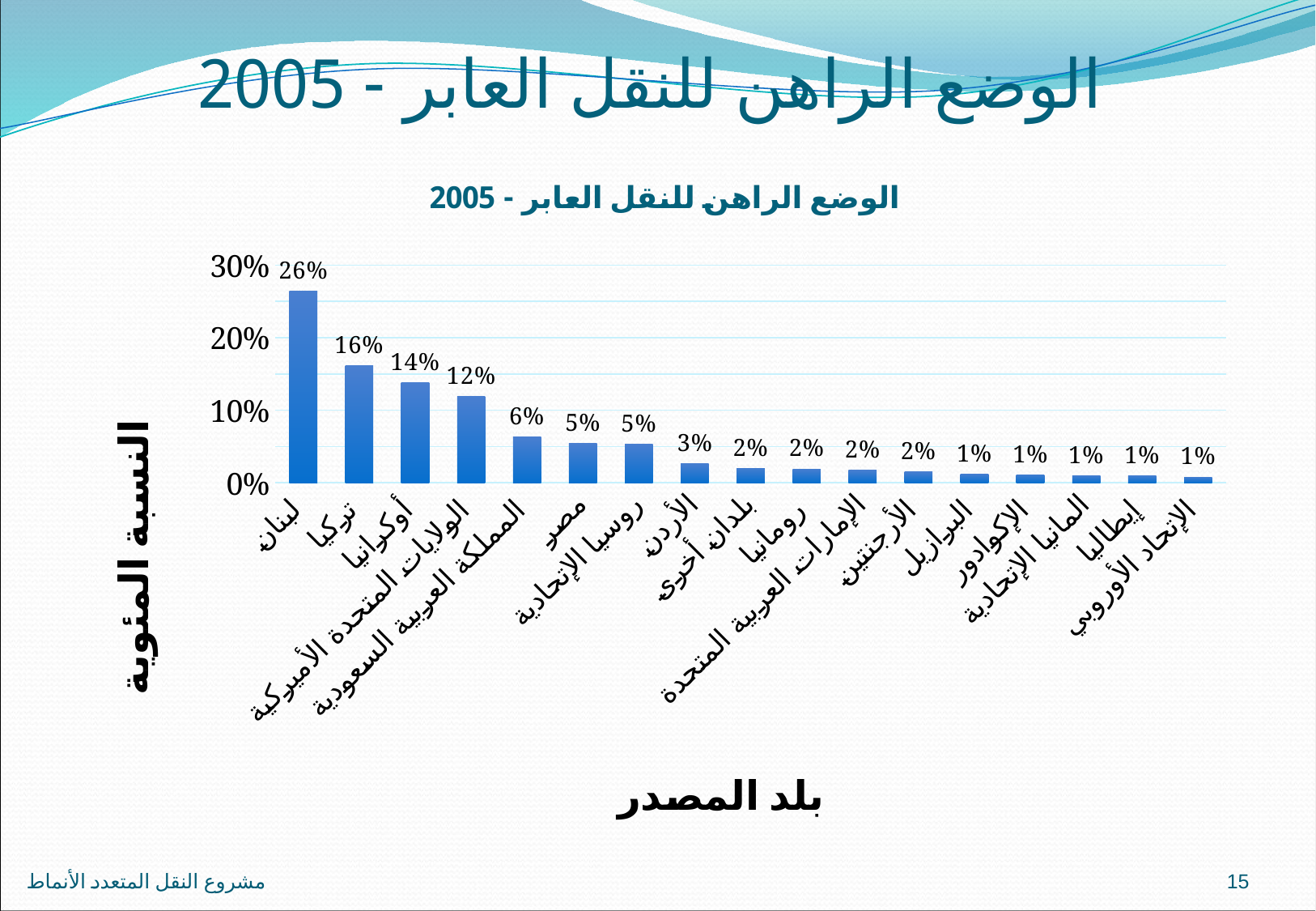
What is the title of the chart? الوضع الراهن للنقل العابر - 2005 What is the value for المملكة العربية السعودية? 6% What is the difference between the values for لبنان and تركيا? 10% What is the value for لبنان? 26% How many countries/categories are shown on the x axis? 17 What is the value for أوكرانيا? 14% Which country has the highest value? لبنان Which is larger, the value for مصر or the value for الأردن? مصر What is the value for تركيا? 16% Do the values rise or fall from left to right along the x axis? Fall What is the difference between the values for الولايات المتحدة الأميركية and الأردن? 9% What type of chart is shown on the slide? Bar chart